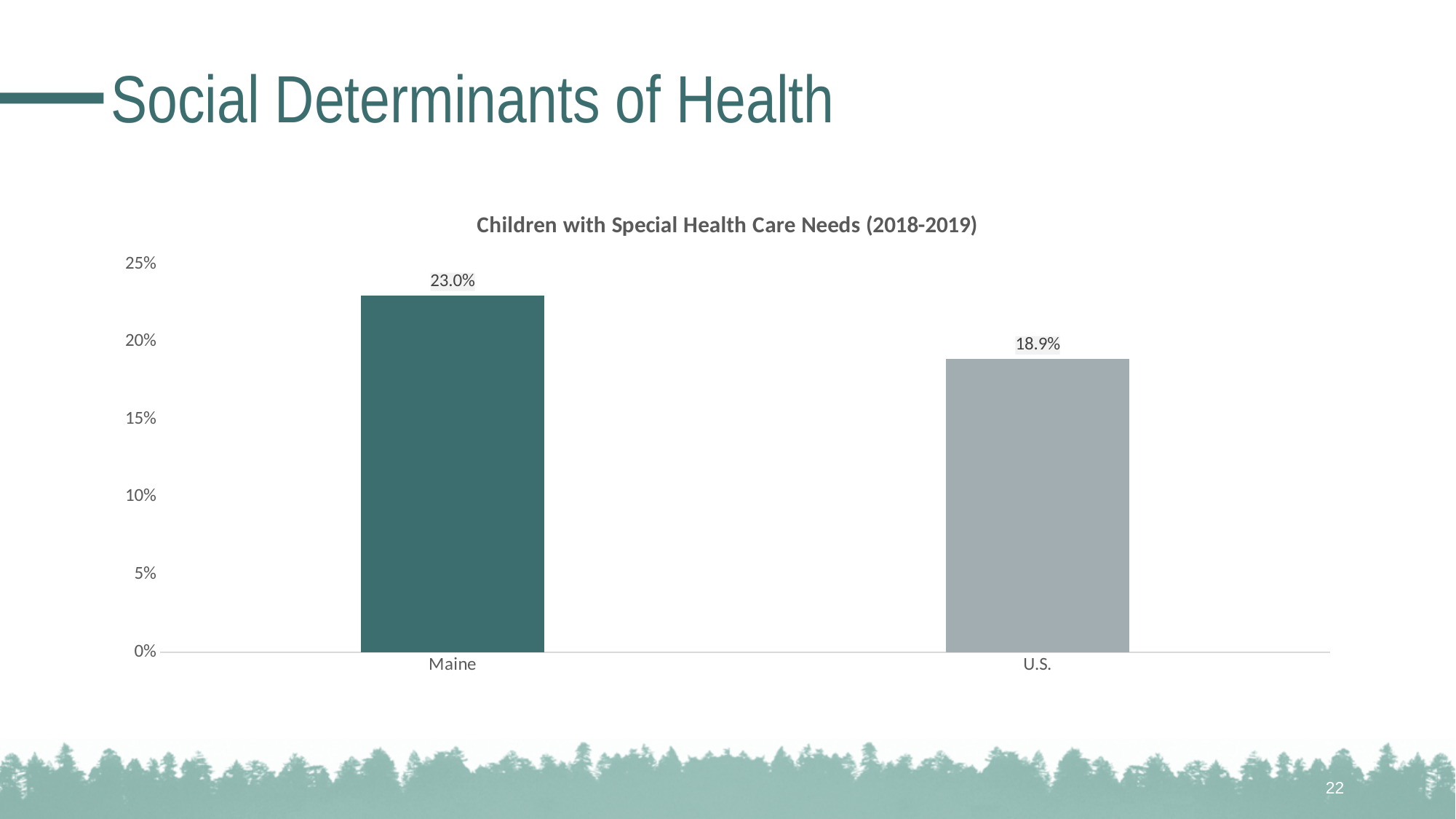
Is the value for U.S. greater or less than 20%? less Is the value for Maine greater or less than 20%? greater Which category has the highest value in the chart? Maine What is the difference between the Maine and U.S. values? 4.1% What is the title of the chart? Children with Special Health Care Needs (2018-2019) What is the value for Maine in the Children with Special Health Care Needs chart? 23.0% What is the value for U.S. in the Children with Special Health Care Needs chart? 18.9% What kind of chart is shown on the slide? bar chart What is the highest value shown on the y axis of the chart? 25% How many categories are shown on the x axis of the chart? 2 Which category has the lowest value in the chart? U.S. Which is larger, the value for Maine or the value for U.S.? Maine